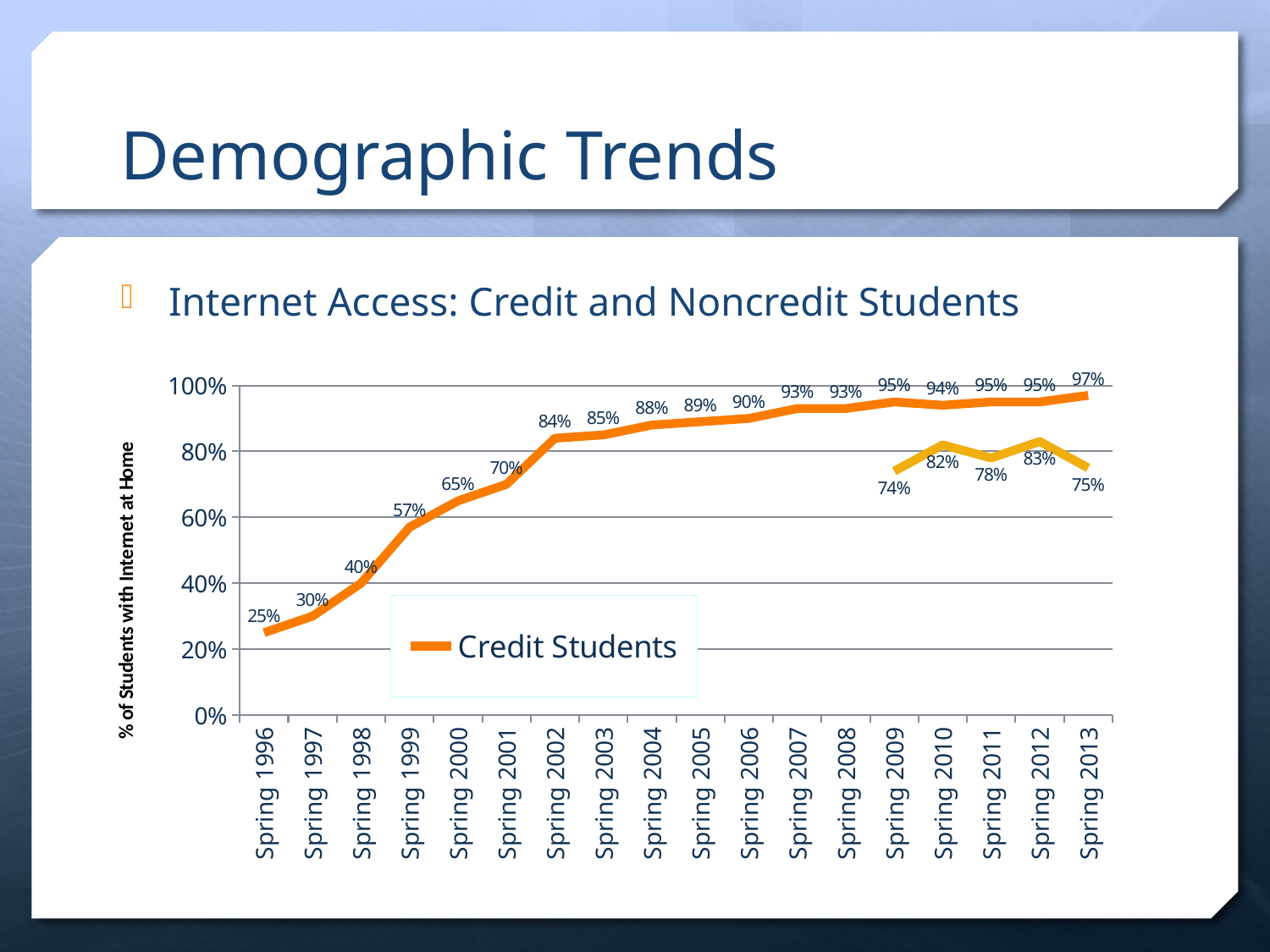
Which is larger for Credit Students: Spring 2001 or Spring 2002? Spring 2002 What is the difference between the Credit Students values for Spring 1999 and Spring 1998? 17% How many time periods are shown on the x axis? 18 In which period is the Credit Students value highest? Spring 2013 What type of chart is shown on the slide? Line chart What is the value for Credit Students in Spring 2013? 97% What is the value for Credit Students in Spring 2002? 84% Do the Credit Students values generally rise or fall from Spring 1996 to Spring 2013? Rise What is the value for Credit Students in Spring 1996? 25% In which period is the Credit Students value lowest? Spring 1996 What is the value shown on the yellow line for Spring 2011? 78% How many series does the legend list? 1